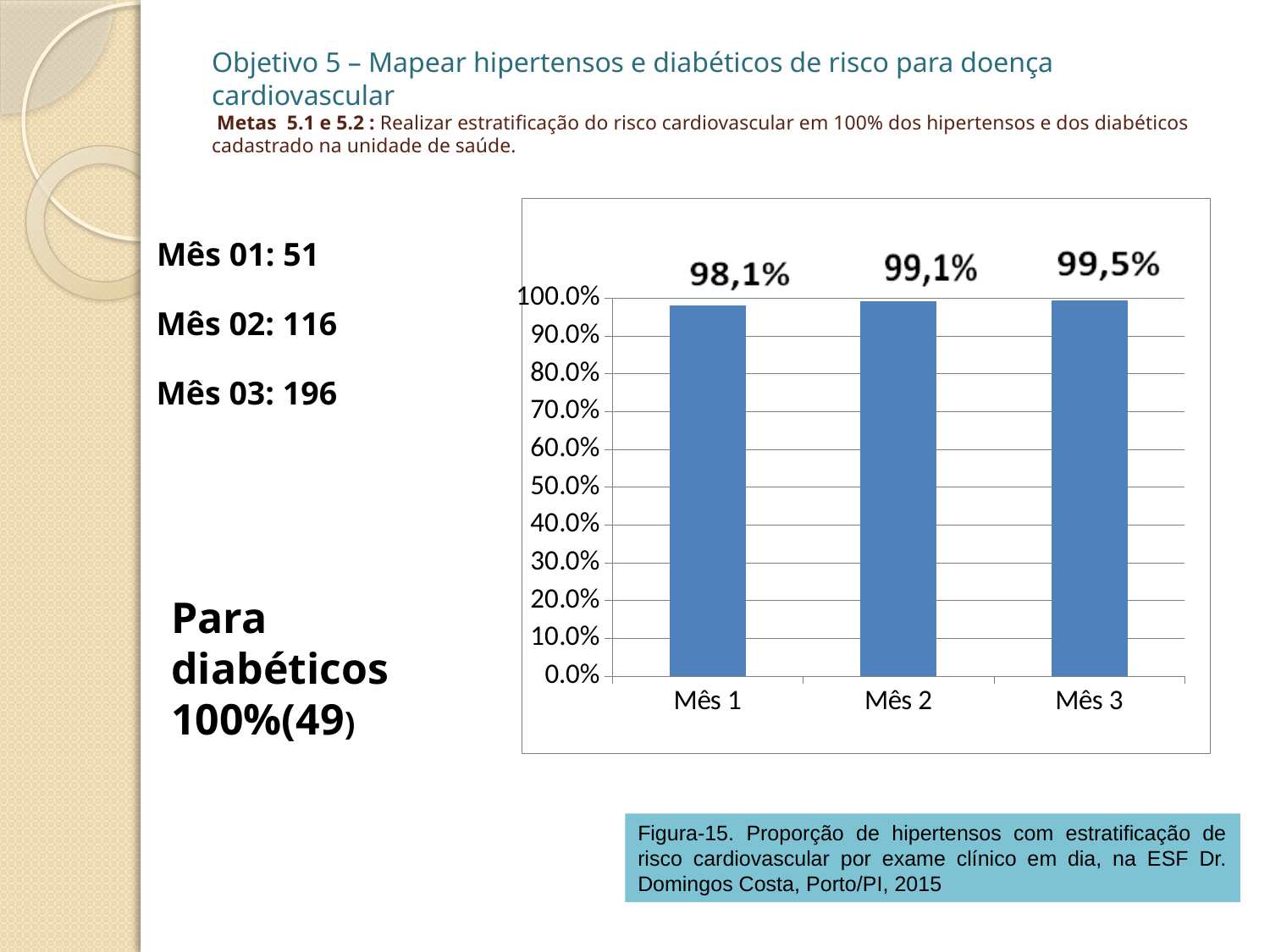
What is the value for Mês 1? 98,1% How many bars are shown in the chart? 3 Do the values rise or fall from Mês 1 to Mês 3? rise What is the value for Mês 3? 99,5% Which is larger, the value for Mês 2 or the value for Mês 1? Mês 2 What figure number is given in the caption below the chart? Figura-15 Is the value for Mês 1 greater or less than 90.0%? greater Which month has the lowest value? Mês 1 What is the difference between the values for Mês 3 and Mês 1? 1,4% What kind of chart is shown on the slide? bar chart Which month has the highest value? Mês 3 What is the value for Mês 2? 99,1%